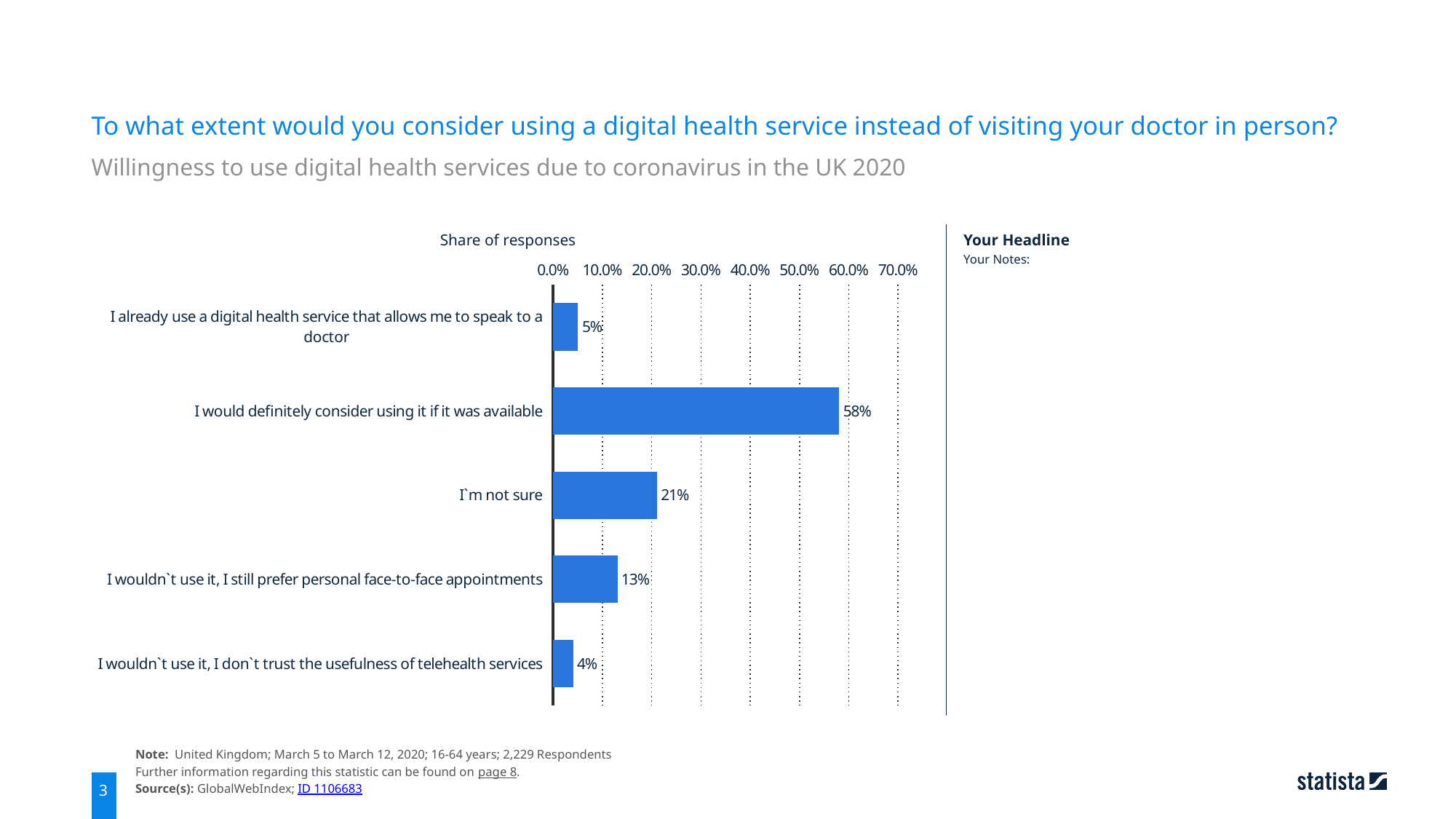
What share of respondents answered 'I'm not sure'? 21% What type of chart is shown on the slide? Bar chart What is the difference in share between 'I would definitely consider using it if it was available' and 'I'm not sure'? 37% What is the label of the horizontal axis of the chart? Share of responses Which has a larger share: 'I'm not sure' or 'I wouldn't use it, I still prefer personal face-to-face appointments'? I'm not sure Which response category has the lowest share? I wouldn't use it, I don't trust the usefulness of telehealth services What share of respondents said they already use a digital health service that allows them to speak to a doctor? 5% What share of respondents said they wouldn't use it because they still prefer personal face-to-face appointments? 13% How many response categories are shown in the chart? 5 Which response category has the highest share? I would definitely consider using it if it was available What share of respondents said they would definitely consider using a digital health service if it was available? 58% Is the value for 'I would definitely consider using it if it was available' greater or less than 50.0%? greater